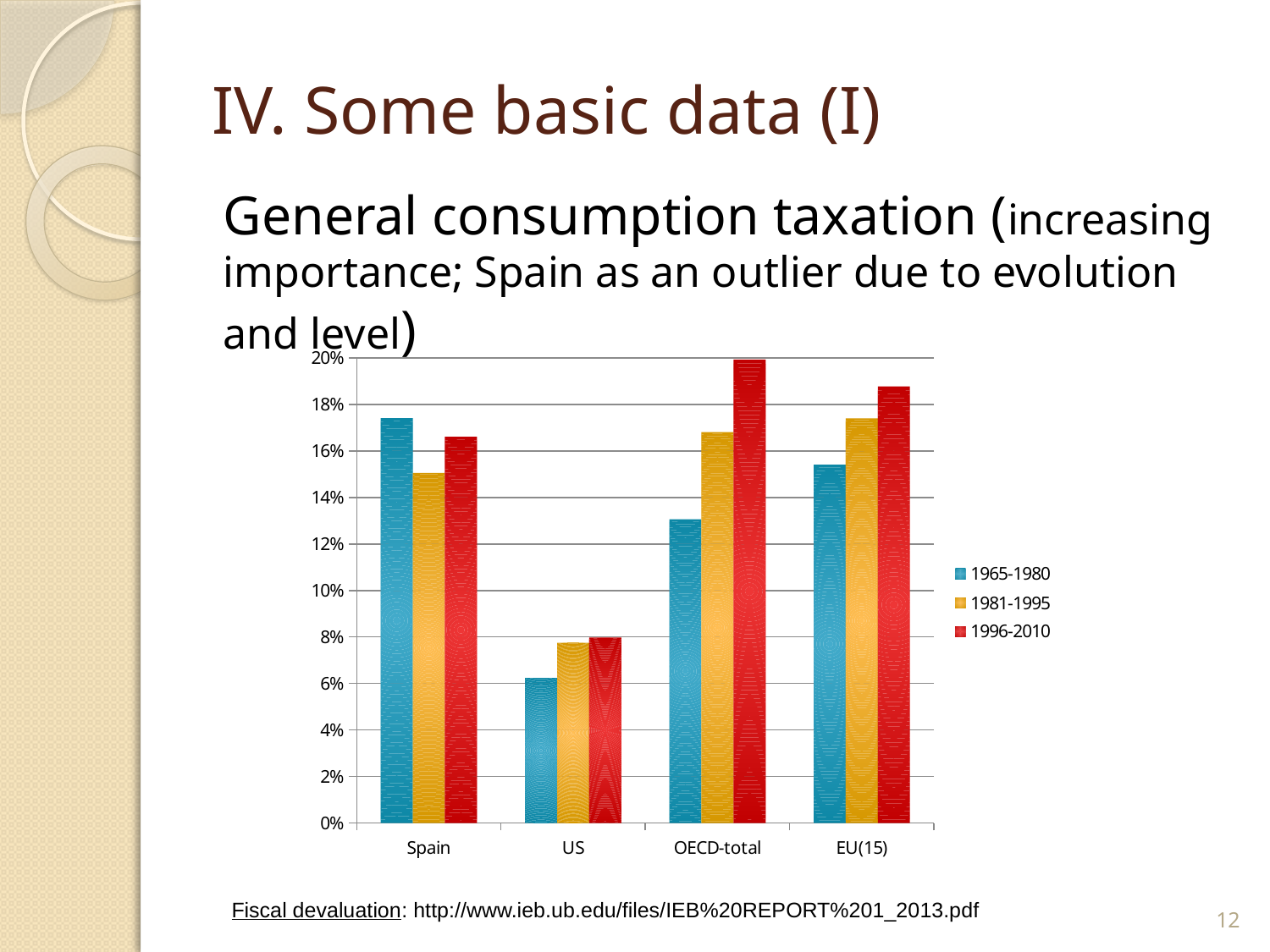
How many series does the chart's legend list? 3 Which category has the lowest bar for the 1965-1980 series? US For the 1996-2010 series, which is larger: Spain or EU(15)? EU(15) Is the value for Spain in 1981-1995 greater or less than 14%? greater Is the value for US in 1965-1980 greater or less than 8%? less How many categories are shown on the x axis of the chart? 4 For Spain, which is larger: the 1965-1980 bar or the 1981-1995 bar? 1965-1980 What kind of chart is shown on the slide? bar chart For OECD-total, do the values rise or fall from 1965-1980 to 1996-2010? rise Is the value for OECD-total in 1996-2010 greater or less than 18%? greater What are the three series listed in the chart's legend? 1965-1980, 1981-1995, 1996-2010 Which category has the highest bar for the 1996-2010 series? OECD-total